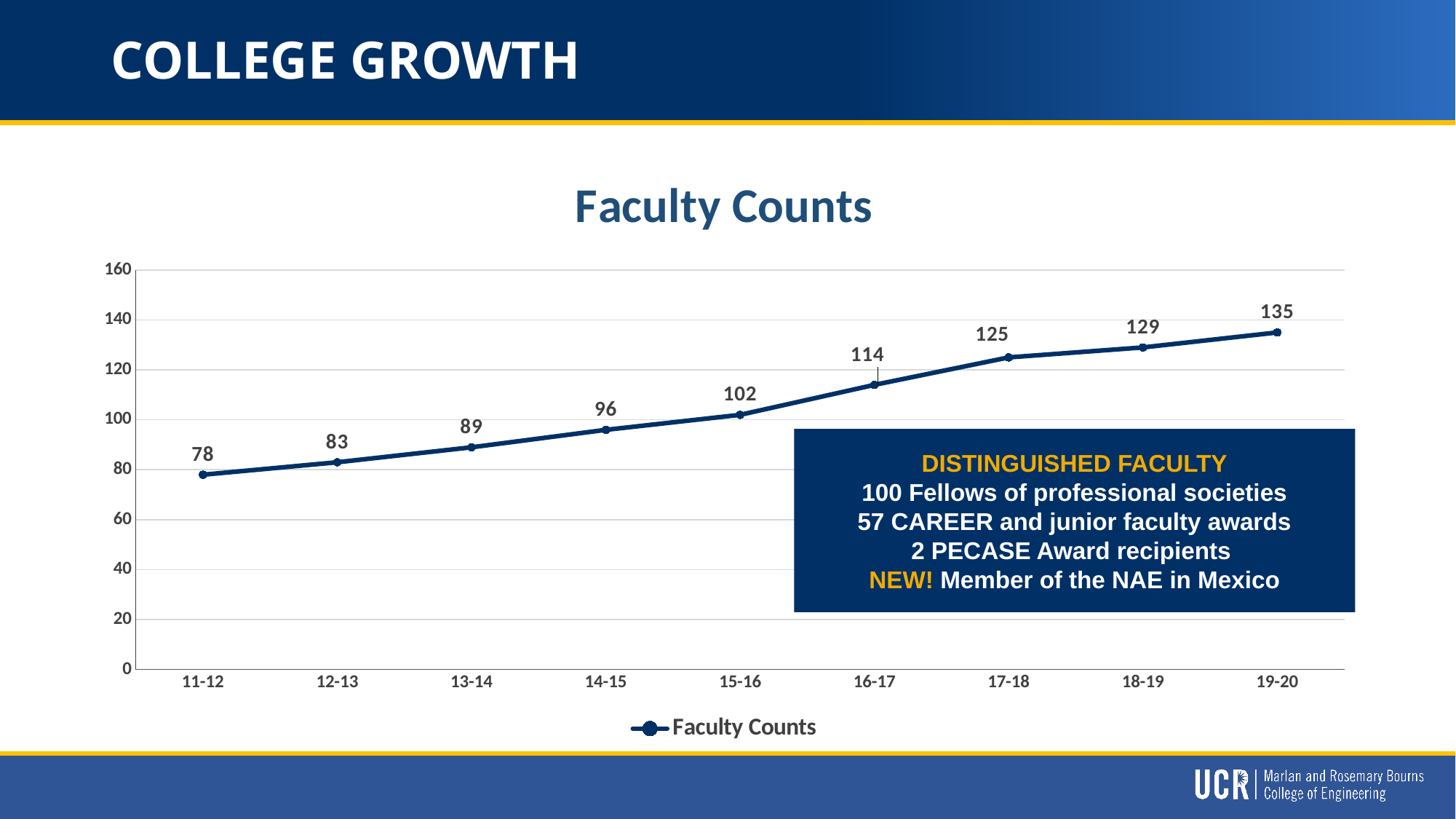
What is the faculty count for 16-17? 114 Which year has the lowest faculty count? 11-12 What is the difference in faculty count between 17-18 and 16-17? 11 What is the faculty count for 11-12? 78 What is the difference in faculty count between 19-20 and 11-12? 57 What is the faculty count for 19-20? 135 Do faculty counts rise or fall from 11-12 to 19-20? rise Is the faculty count for 18-19 greater or less than 120? greater Which year has a larger faculty count, 14-15 or 15-16? 15-16 What kind of chart is shown on the slide? line chart How many academic years are plotted on the chart? 9 Which year has the highest faculty count? 19-20